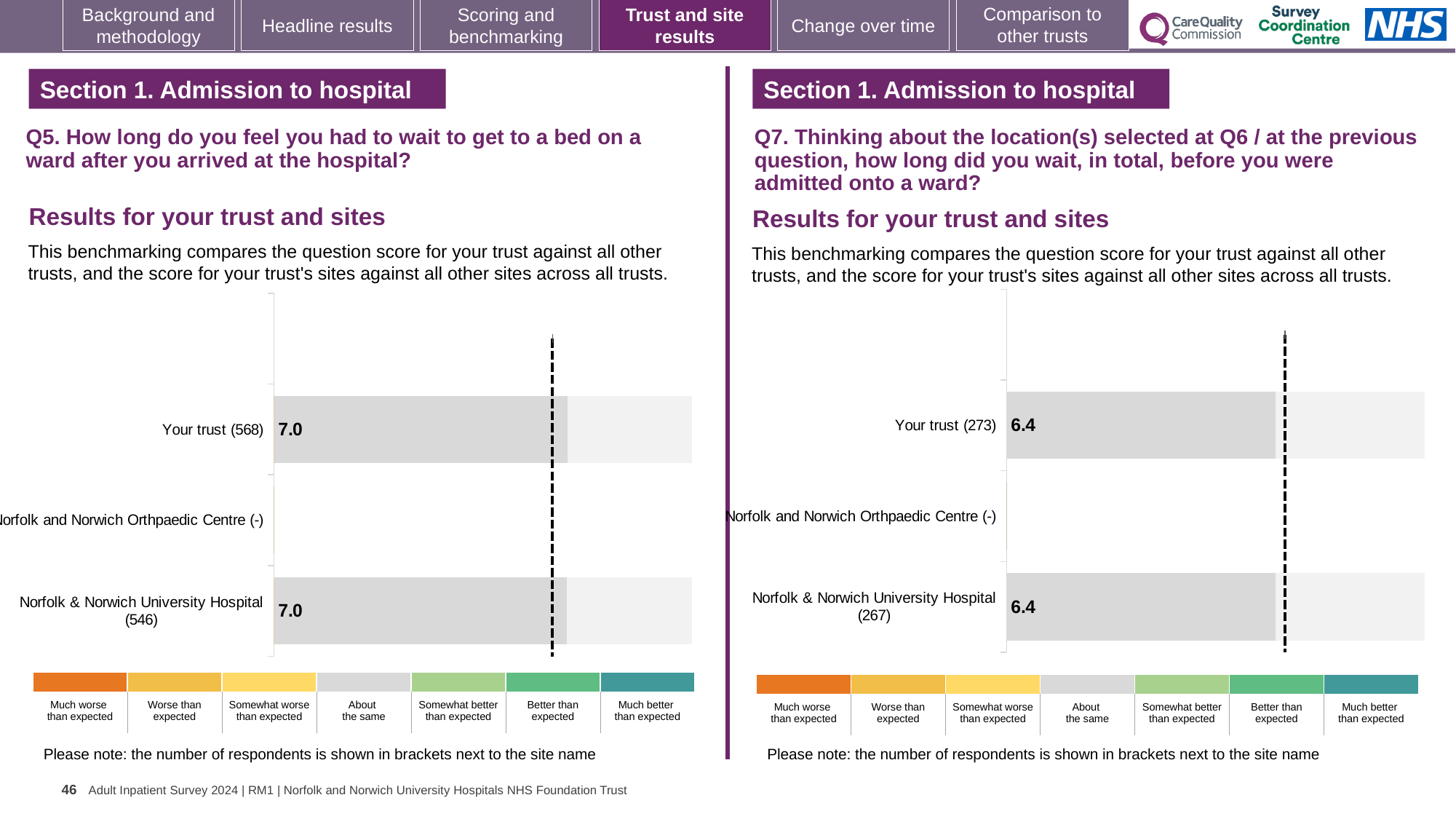
On the left chart (Q5), how many respondents are shown in brackets next to Your trust? 568 What kind of chart is the left chart (Q5)? bar chart On the right chart (Q7), how many categories are listed on the vertical axis? 3 On the left chart (Q5), how many categories are listed on the vertical axis? 3 On the right chart (Q7), what is the score for Norfolk & Norwich University Hospital? 6.4 On the right chart (Q7), what is the score for Your trust? 6.4 On the left chart (Q5), what is the score for Your trust? 7.0 On the right chart (Q7), which category has no bar or score shown? Norfolk and Norwich Orthopaedic Centre (-) On the left chart (Q5), what is the score for Norfolk & Norwich University Hospital? 7.0 On the left chart (Q5), what is the difference between the score for Your trust and the score for Norfolk & Norwich University Hospital? 0.0